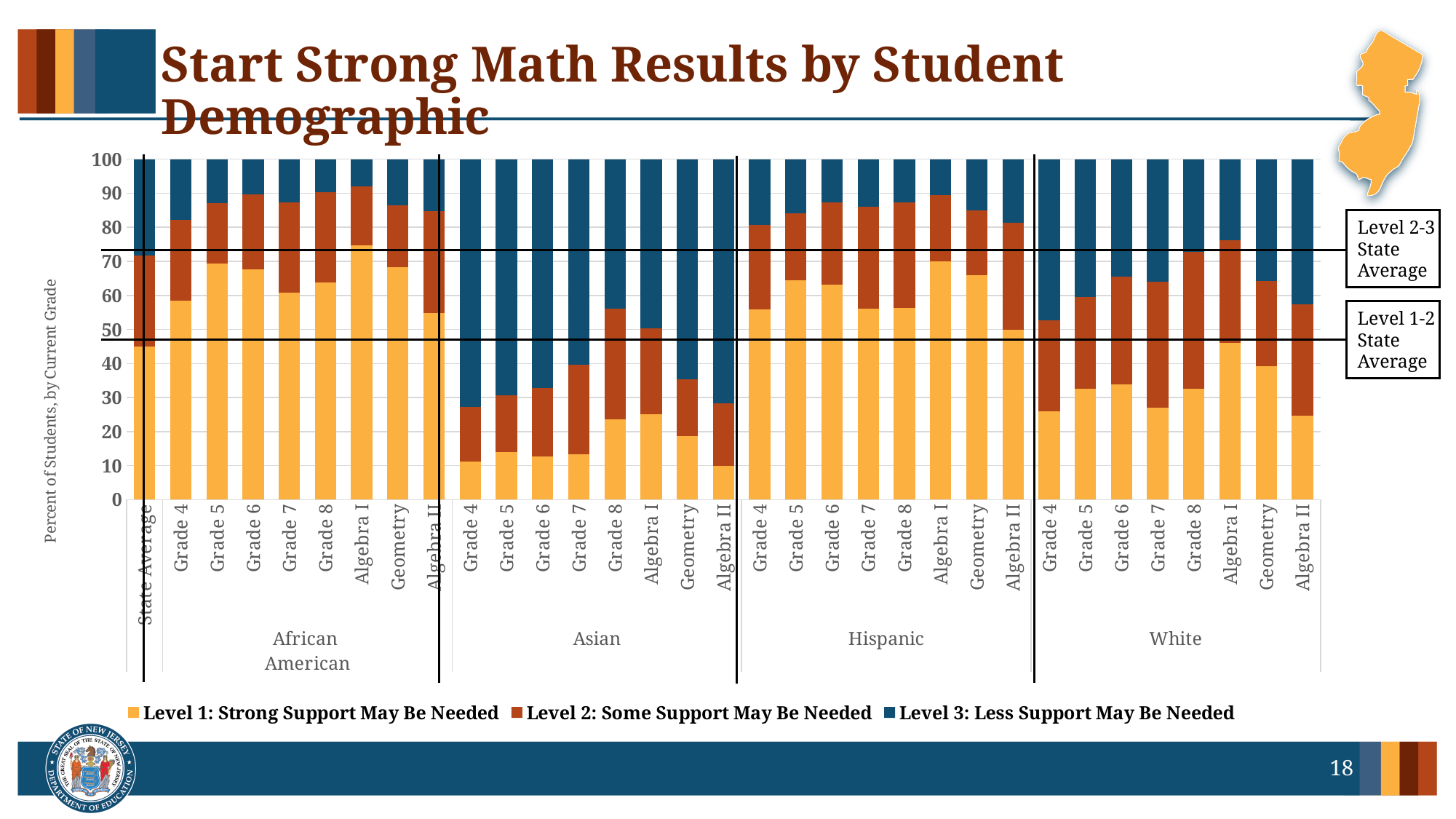
How many series does the legend list? 3 Which has the larger Level 1 value: Asian Grade 4 or Hispanic Grade 4? Hispanic Grade 4 What is the label on the vertical axis? Percent of Students, by Current Grade Is the Level 1 value for White Grade 4 greater or less than 30? less Is the Level 1 value for Hispanic Grade 5 greater or less than 50? greater How many bars are shown for each demographic group? 8 Is the Level 1 value for African American Algebra I greater or less than 60? greater Within the White group, which grade or course has the highest Level 1 value? Algebra I Which demographic group has the lowest Level 1 values across its grades? Asian What kind of chart is shown on the slide? Stacked bar chart How many student demographic groups are shown along the x axis (excluding the State Average bar)? 4